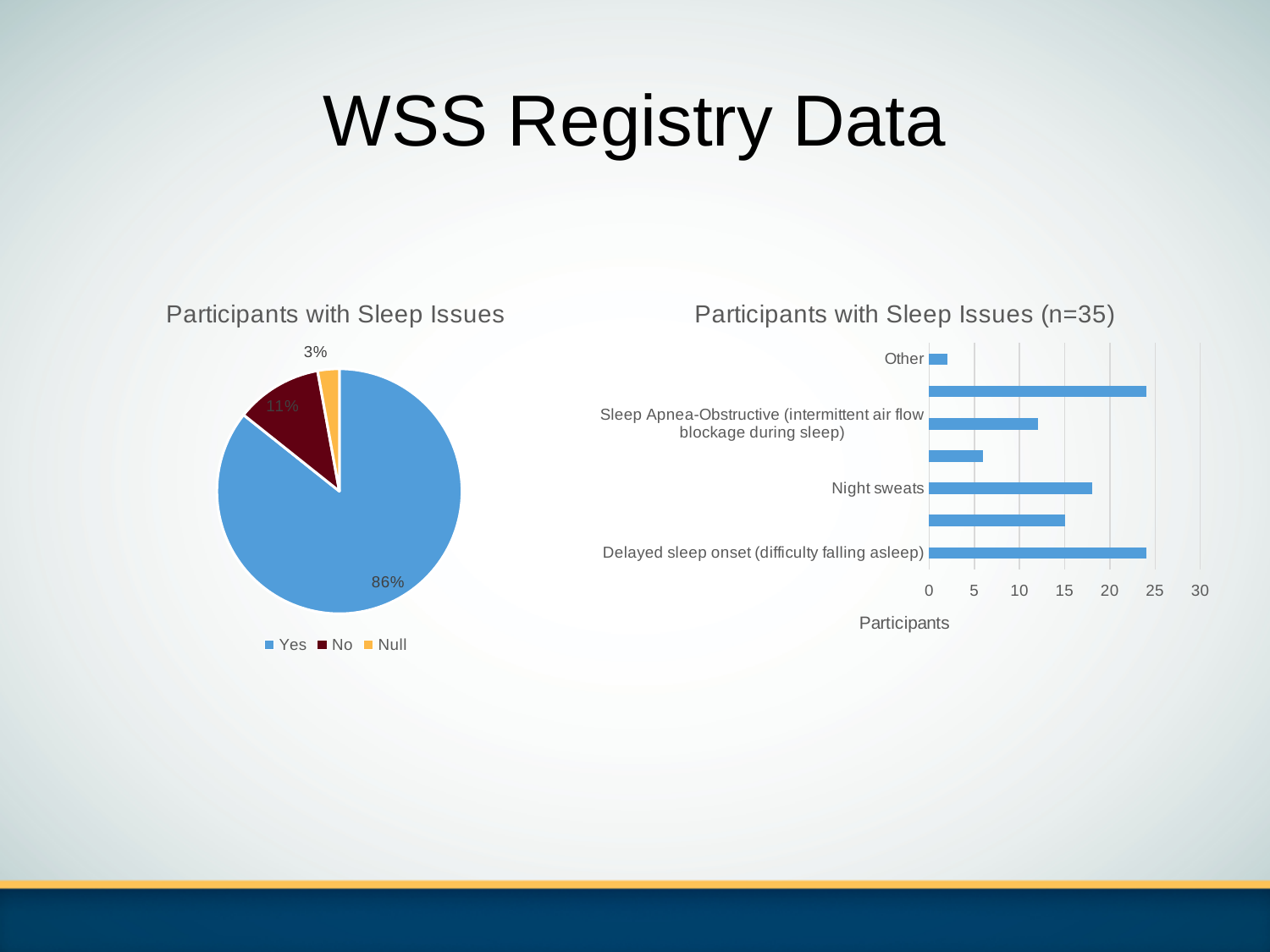
In the pie chart 'Participants with Sleep Issues', what percentage of participants answered Yes? 86% In the pie chart 'Participants with Sleep Issues', what percentage is the Null slice? 3% How many entries does the legend of the pie chart 'Participants with Sleep Issues' list? 3 In the bar chart 'Participants with Sleep Issues (n=35)', which has more participants: Night sweats or Sleep Apnea-Obstructive? Night sweats In the pie chart 'Participants with Sleep Issues', which category has the smallest slice? Null What kind of chart is the right chart titled 'Participants with Sleep Issues (n=35)'? Bar chart In the bar chart 'Participants with Sleep Issues (n=35)', is the value for Night sweats greater or less than 15? greater In the pie chart 'Participants with Sleep Issues', what percentage of participants answered No? 11% In the bar chart 'Participants with Sleep Issues (n=35)', is the value for Other greater or less than 5? less What kind of chart is the left chart titled 'Participants with Sleep Issues'? Pie chart In the bar chart 'Participants with Sleep Issues (n=35)', how many bars are plotted? 7 In the pie chart 'Participants with Sleep Issues', how many percentage points larger is the Yes slice than the No slice? 75 percentage points